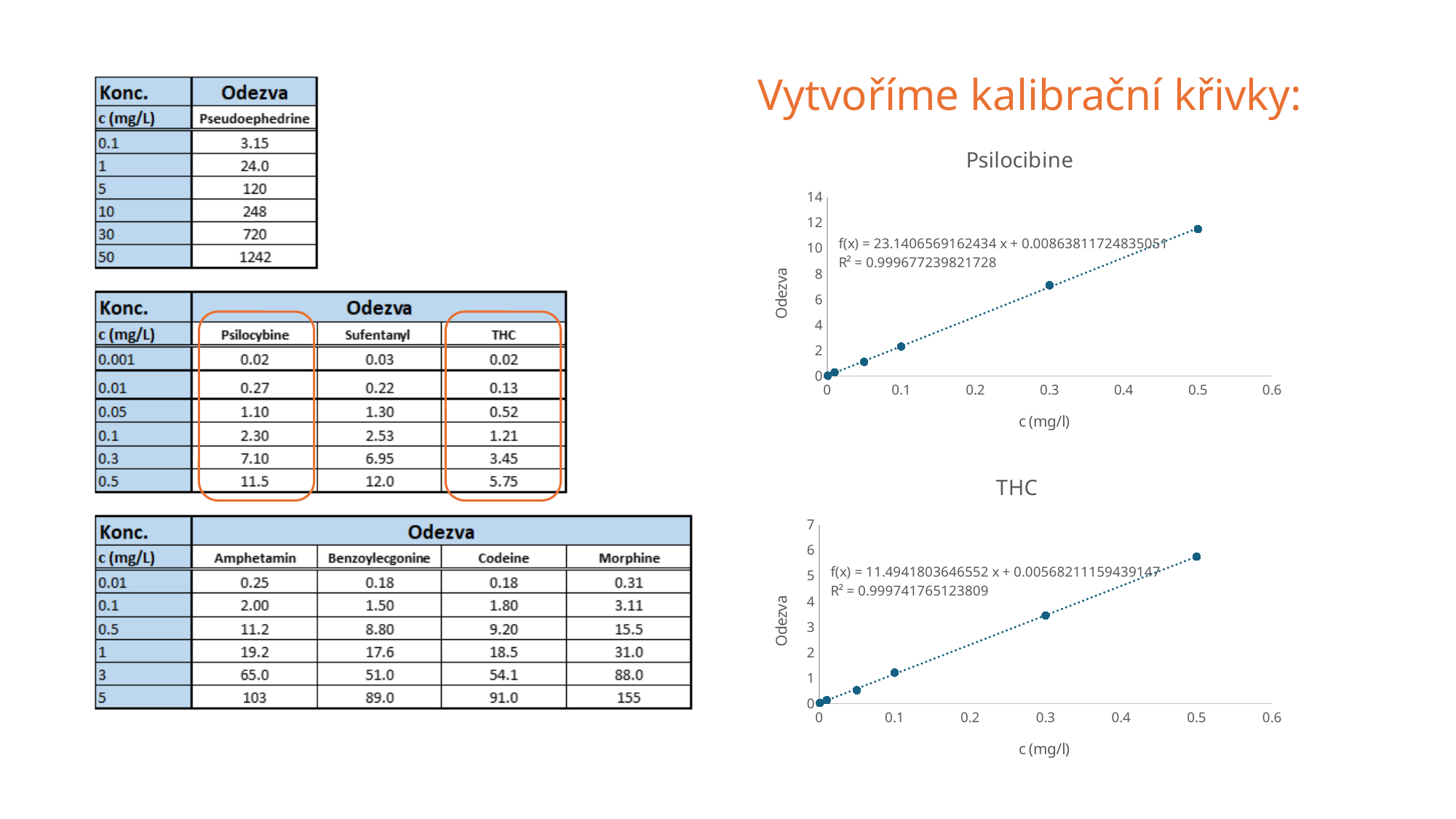
In the Psilocibine chart, is the value at c = 0.3 greater or less than 8? less In the THC chart, is the value at c = 0.1 greater or less than 2? less In the THC chart, do the values rise or fall as concentration increases along the x axis? rise In the THC chart, is the value at c = 0.5 greater or less than 5? greater What kind of chart is the Psilocibine chart? scatter chart What R² value is printed on the Psilocibine chart? R² = 0.999677239821728 In the Psilocibine chart, do the values rise or fall as concentration increases along the x axis? rise What is the slope in the trendline equation printed on the THC chart? 11.4941803646552 In the THC chart, at which concentration is the plotted response highest? 0.5 In the Psilocibine chart, which concentration has the highest response: 0.3 or 0.5? 0.5